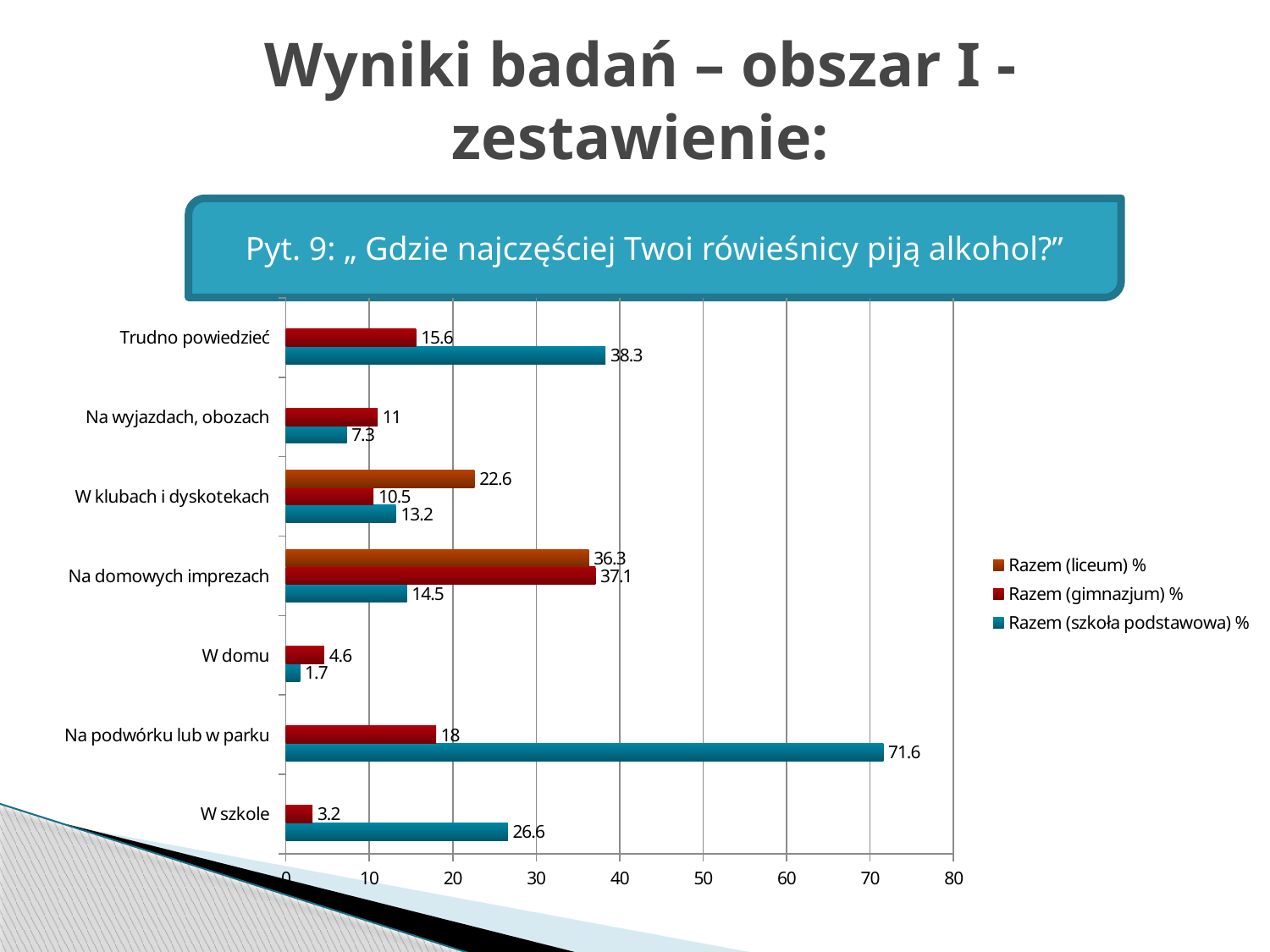
For 'Na wyjazdach, obozach', which series has the larger value: 'Razem (gimnazjum) %' or 'Razem (szkoła podstawowa) %'? Razem (gimnazjum) % What is the difference between the 'Razem (szkoła podstawowa) %' and 'Razem (gimnazjum) %' values for 'Trudno powiedzieć'? 22.7 Which category has the lowest value in the 'Razem (gimnazjum) %' series? W szkole Which category has the highest value in the 'Razem (szkoła podstawowa) %' series? Na podwórku lub w parku Is the value for 'W szkole' in the 'Razem (szkoła podstawowa) %' series greater or less than 20? greater What is the value for 'W klubach i dyskotekach' in the 'Razem (liceum) %' series? 22.6 How many series does the legend list? 3 What type of chart is shown on the slide? bar chart What is the value for 'Na podwórku lub w parku' in the 'Razem (szkoła podstawowa) %' series? 71.6 What is the value for 'Na domowych imprezach' in the 'Razem (gimnazjum) %' series? 37.1 How many categories are shown on the vertical axis of the chart? 7 What question is quoted in the box above the chart? Pyt. 9: „ Gdzie najczęściej Twoi rówieśnicy piją alkohol?”